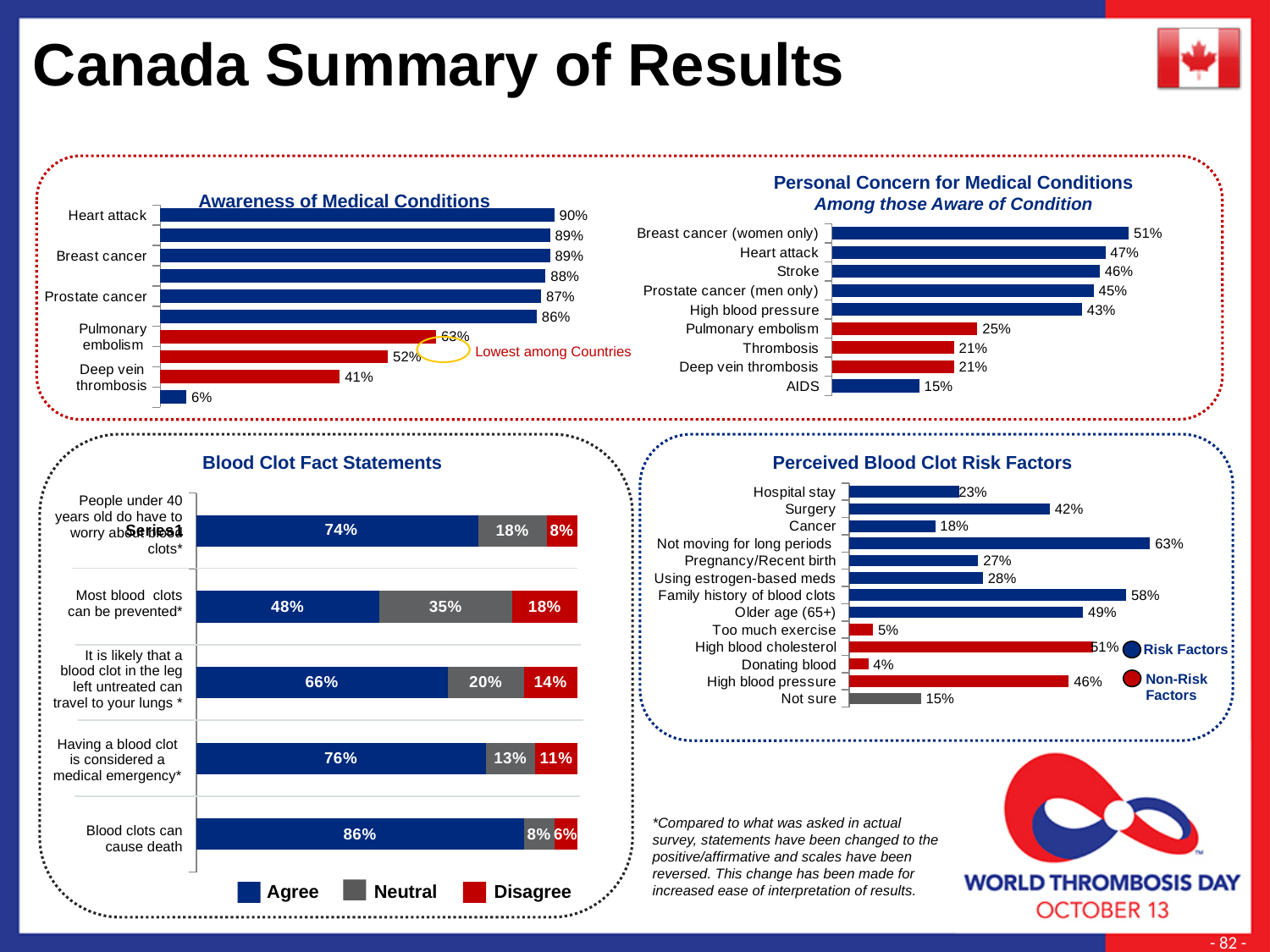
In the Blood Clot Fact Statements chart, how many series does the legend list? 3 In the Personal Concern for Medical Conditions chart, what is the value for Stroke? 46% In the Personal Concern for Medical Conditions chart, how many conditions are listed? 9 In the Perceived Blood Clot Risk Factors chart, what is the value for Donating blood? 4% In the Perceived Blood Clot Risk Factors chart, which factor has the highest value? Not moving for long periods What kind of chart is the Blood Clot Fact Statements chart? Stacked bar chart In the Personal Concern for Medical Conditions chart, what is the difference between Breast cancer (women only) and Pulmonary embolism? 26% In the Awareness of Medical Conditions chart, what is the value for Heart attack? 90% In the Blood Clot Fact Statements chart, what is the total of the stacked bar for 'Most blood clots can be prevented'? 101% In the Blood Clot Fact Statements chart, what percentage agree that blood clots can cause death? 86% In the Personal Concern for Medical Conditions chart, which condition has the lowest value? AIDS In the Perceived Blood Clot Risk Factors chart, which is larger, Surgery or Older age (65+)? Older age (65+)